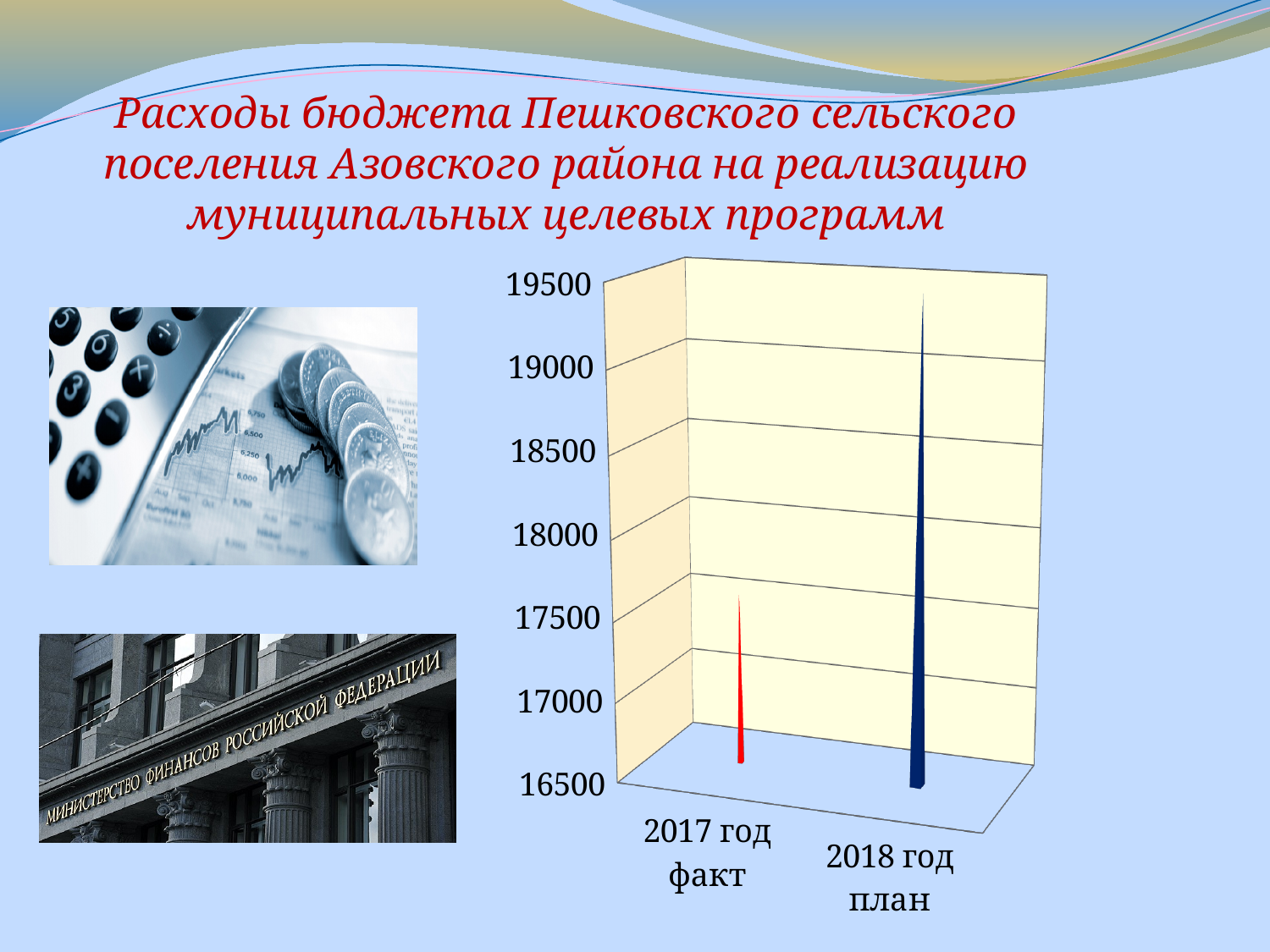
Is the value for 2018 год план greater or less than 19000? greater Which category has the lowest value on the chart? 2017 год факт Do the values rise or fall from 2017 год факт to 2018 год план? rise What kind of chart is shown on the slide? bar chart What colour is the bar for 2017 год факт? red What is the lowest value shown on the vertical axis of the chart? 16500 Which is larger, the value for 2017 год факт or the value for 2018 год план? 2018 год план How many categories are plotted on the chart? 2 Is the value for 2018 год план greater or less than 18500? greater Which category has the highest value on the chart? 2018 год план Is the value for 2017 год факт greater or less than 17000? greater